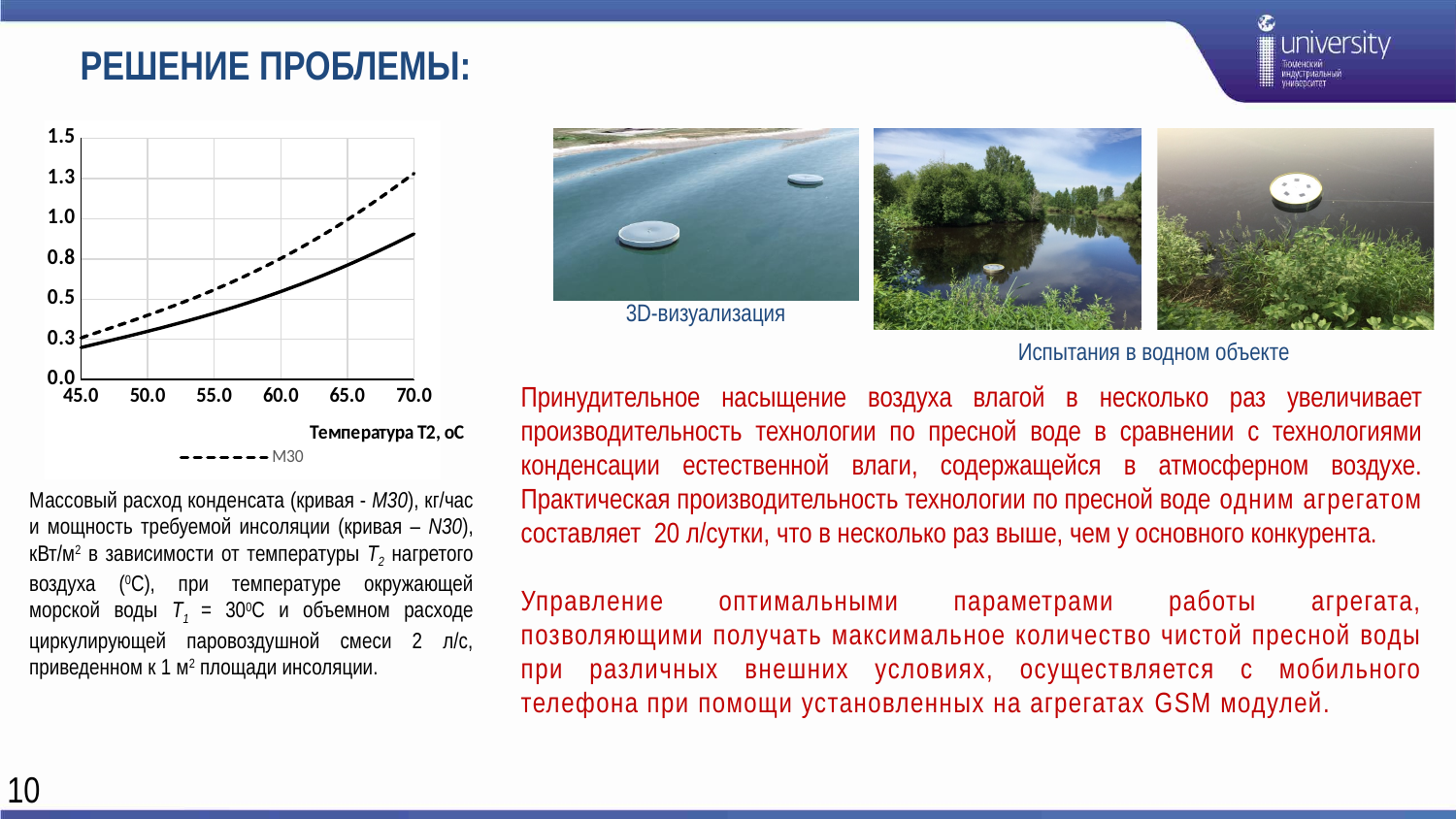
Is the value of the dashed M30 curve at T2 = 55.0 greater or less than 0.5? greater What series name appears in the chart legend? M30 At T2 = 70.0, which curve has the larger value, the dashed M30 curve or the solid curve? the dashed M30 curve How many tick labels are shown on the x axis of the chart? 6 What kind of chart is shown on the left of the slide? line chart Do the values of the dashed M30 curve rise or fall as the temperature T2 increases along the x axis? rise Is the value of the solid curve at T2 = 65.0 greater or less than 0.8? less Is the value of the solid curve at T2 = 70.0 greater or less than 1.0? less What is the title of the x axis of the chart? Температура T2, oC How many series does the legend of the chart list? 1 Do the values of the solid curve rise or fall as the temperature T2 increases along the x axis? rise